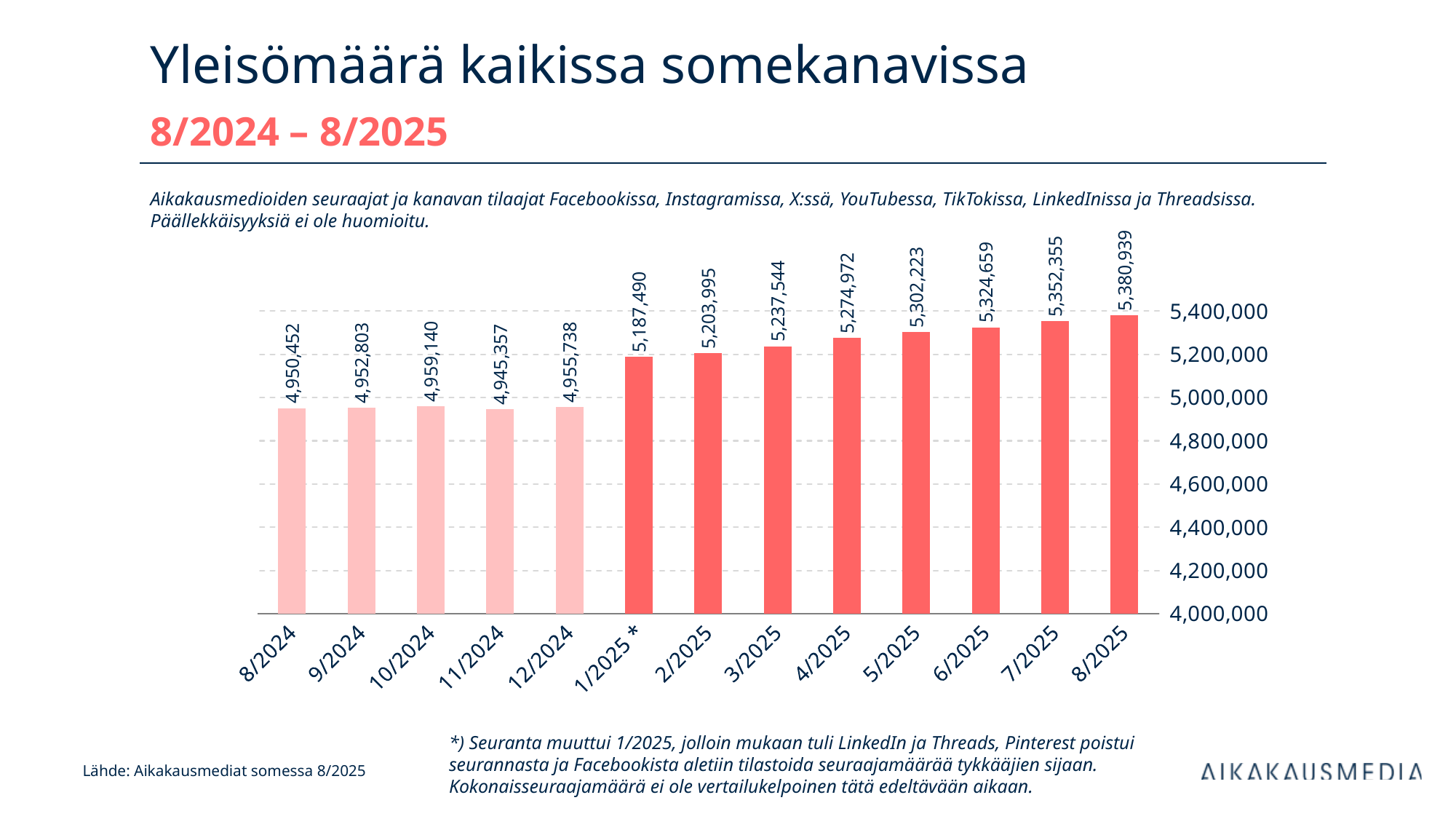
Which month has the lowest value? 11/2024 Is the value for 8/2024 greater or less than 5,000,000? less What is the difference between the values for 8/2025 and 8/2024? 430,487 What is the value for 11/2024? 4,945,357 What kind of chart is shown on the slide? bar chart What is the value for 1/2025 *? 5,187,490 How many months are shown on the x axis? 13 What is the value for 8/2025? 5,380,939 What is the difference between the values for 1/2025 * and 12/2024? 231,752 Do the values generally rise or fall from 1/2025 * to 8/2025? rise Which is larger, the value for 7/2025 or the value for 6/2025? 7/2025 Which month has the highest value? 8/2025